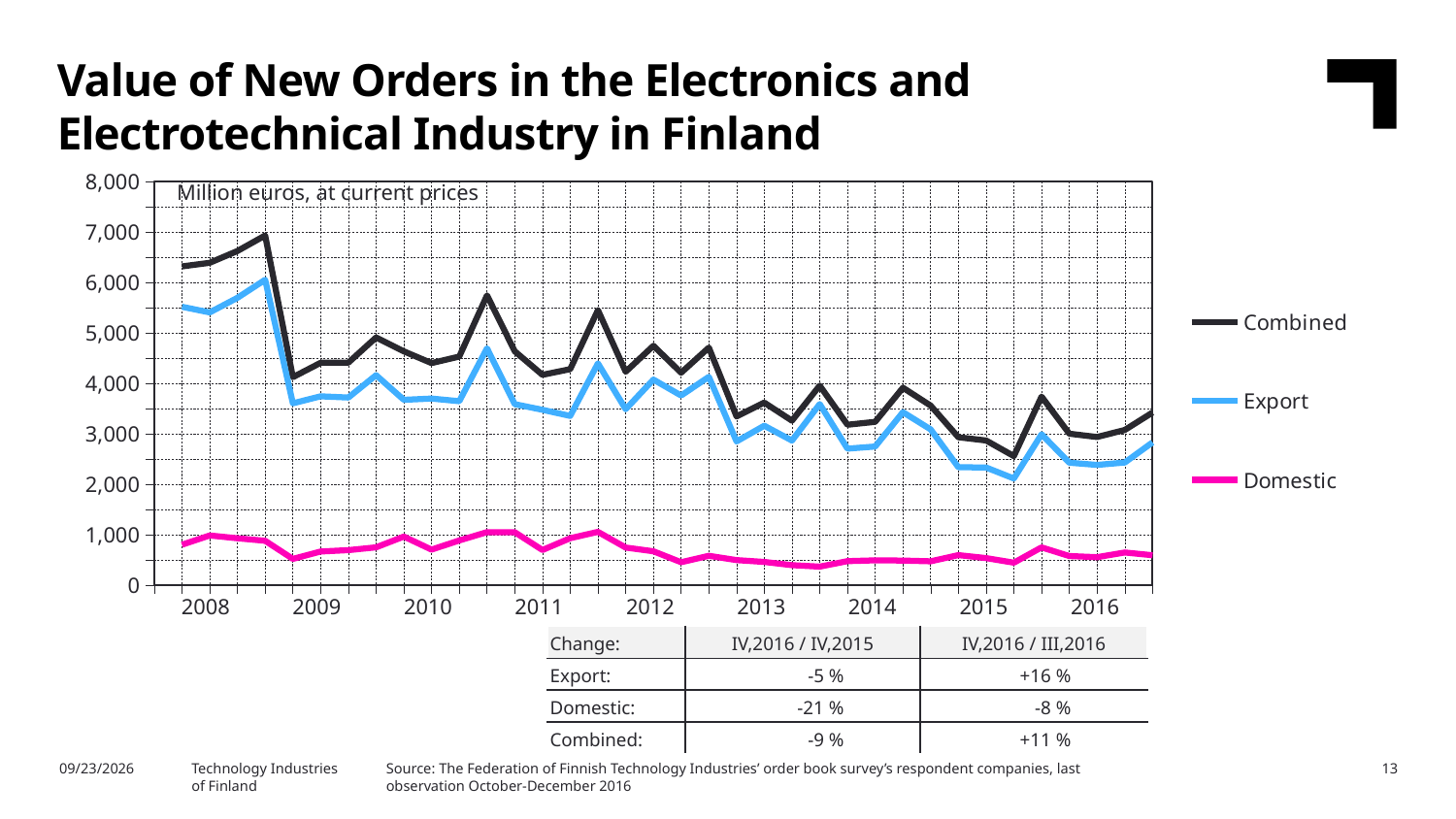
Which is larger in 2010, the Export value or the Domestic value? Export Does the Combined series generally rise or fall from 2008 to 2016? Fall How many series does the chart legend list? 3 Is the value for Domestic in 2012 greater or less than 2,000? less Is the value for Combined at the start of 2008 greater or less than 6,000? greater What colour is the Export line in the legend? Blue Is the value for Export in 2015 greater or less than 3,000? less Which series has the lowest values throughout the chart? Domestic Which series has the highest values throughout the chart? Combined How many year labels are shown on the x axis? 9 What type of chart is shown on the slide? Line chart What unit is stated in the label inside the chart area? Million euros, at current prices